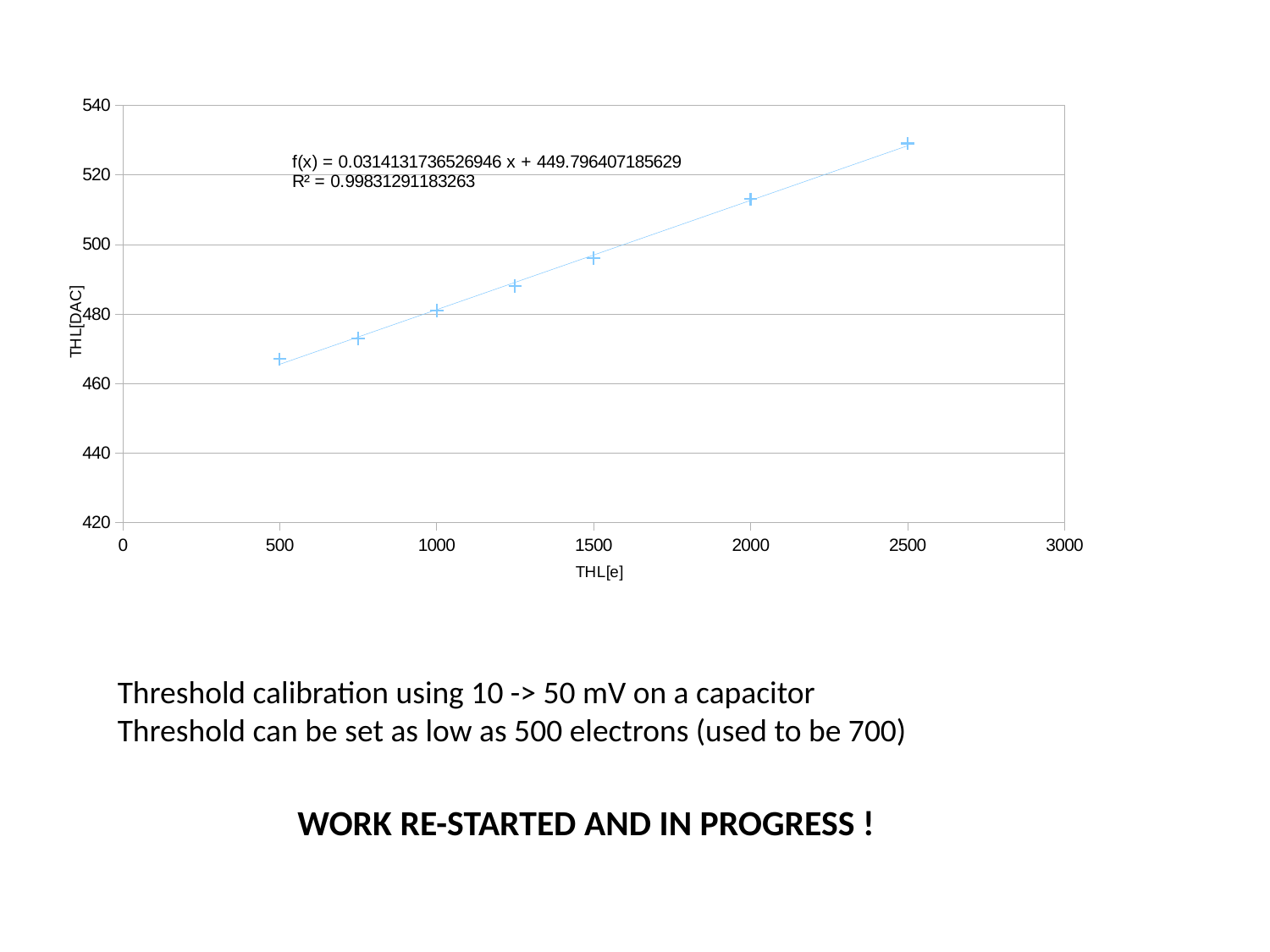
What R² value is printed on the chart for the fitted line? 0.99831291183263 At which THL[e] value is the plotted THL[DAC] lowest? 500 Is the THL[DAC] value at THL[e] = 500 greater or less than 460? greater Is the THL[DAC] value at THL[e] = 2000 greater or less than 500? greater At which THL[e] value is the plotted THL[DAC] highest? 2500 Is the THL[DAC] value at THL[e] = 1500 greater or less than 500? less Which has the larger THL[DAC] value: the point at THL[e] = 2000 or the point at THL[e] = 1000? 2000 Do the THL[DAC] values rise or fall as THL[e] increases along the x axis? rise How many data points are plotted on the chart? 7 What is the label of the y axis of the chart? THL[DAC] What kind of chart is shown on the slide? scatter chart